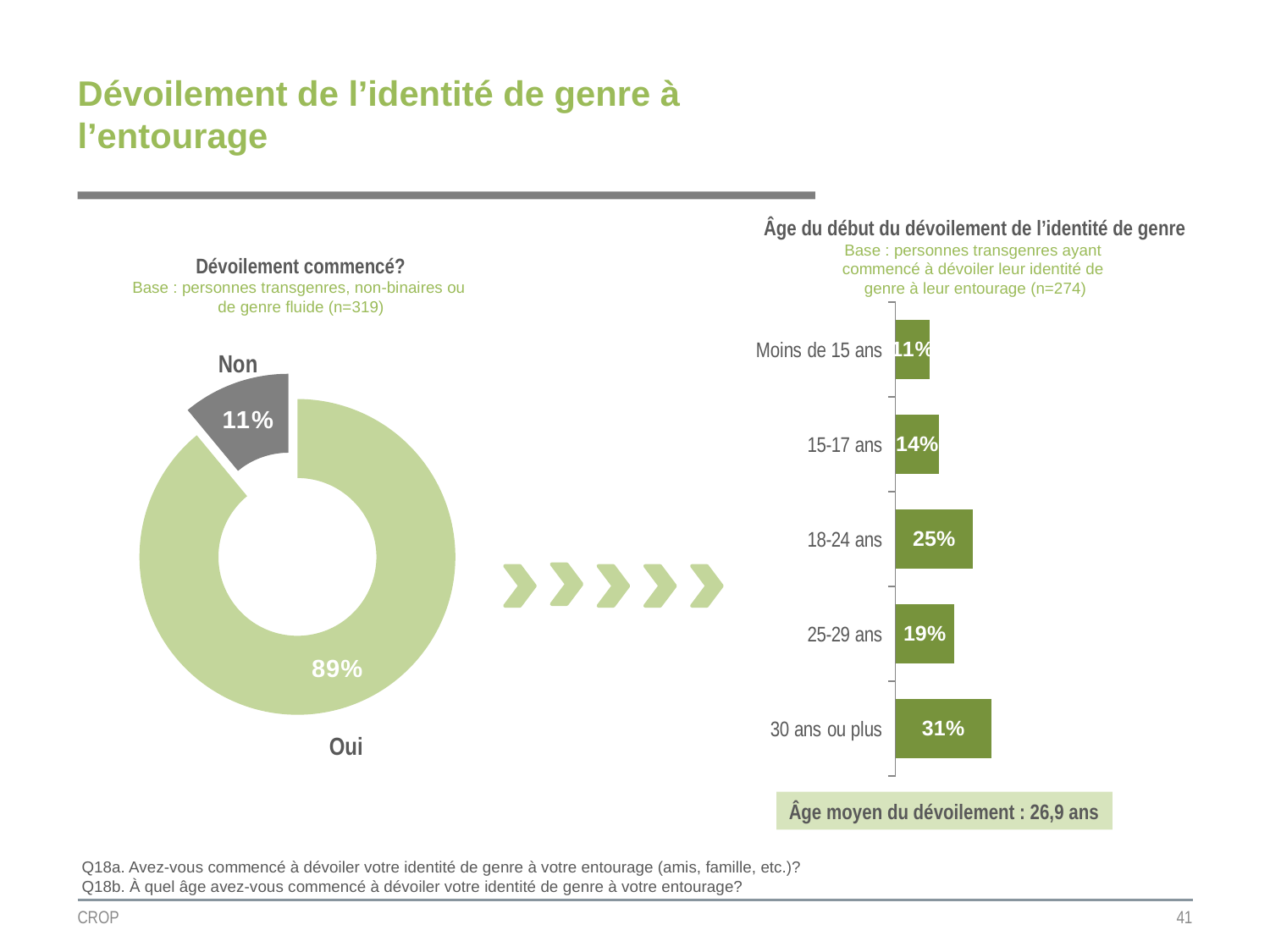
In the 'Âge du début du dévoilement de l'identité de genre' chart, which age group has the lowest value? Moins de 15 ans In the 'Âge du début du dévoilement de l'identité de genre' chart, what is the difference between 30 ans ou plus and 25-29 ans? 12% In the 'Dévoilement commencé?' chart, what percentage answered Non? 11% In the 'Âge du début du dévoilement de l'identité de genre' chart, how many age groups are shown? 5 In the 'Âge du début du dévoilement de l'identité de genre' chart, which age group has the highest value? 30 ans ou plus What kind of chart is the 'Dévoilement commencé?' chart? Pie chart (donut) What kind of chart is the 'Âge du début du dévoilement de l'identité de genre' chart? Bar chart In the 'Dévoilement commencé?' chart, what percentage answered Oui? 89% In the 'Âge du début du dévoilement de l'identité de genre' chart, what is the value for 30 ans ou plus? 31% In the 'Âge du début du dévoilement de l'identité de genre' chart, what is the value for 18-24 ans? 25% In the 'Âge du début du dévoilement de l'identité de genre' chart, which is larger: 15-17 ans or 25-29 ans? 25-29 ans In the 'Dévoilement commencé?' chart, how many categories are shown? 2